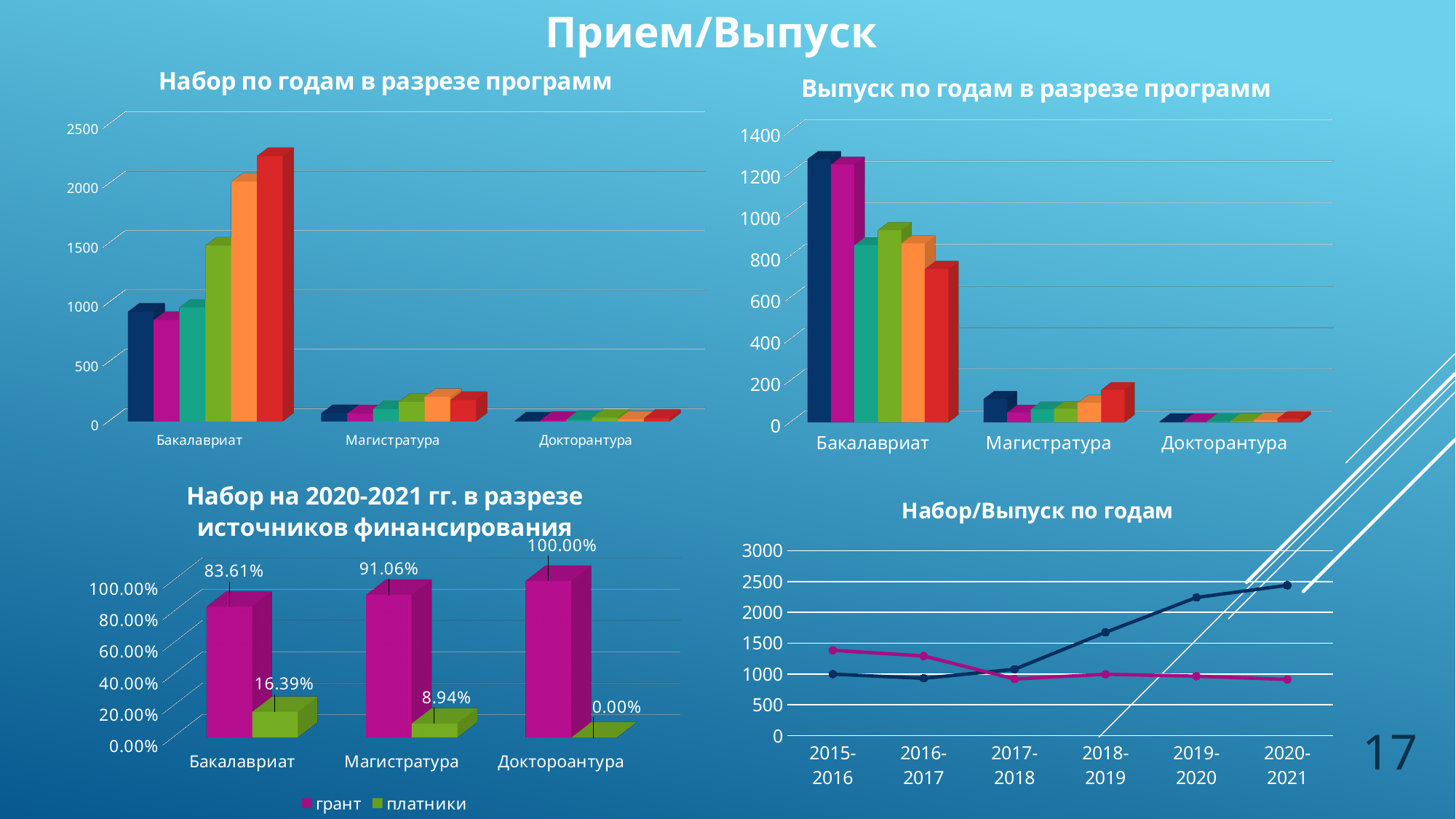
In the chart 'Набор по годам в разрезе программ', is the tallest bar for Бакалавриат greater or less than 2000? greater In the chart 'Набор на 2020-2021 гг. в разрезе источников финансирования', what is the difference between грант and платники for Бакалавриат? 67.22% What kind of chart is 'Выпуск по годам в разрезе программ'? bar chart In the chart 'Набор на 2020-2021 гг. в разрезе источников финансирования', what is the value for платники for Магистратура? 8.94% In the chart 'Набор/Выпуск по годам', does the dark blue line rise or fall from 2017-2018 to 2020-2021? rises How many year periods are shown on the x axis of the chart 'Набор/Выпуск по годам'? 6 How many series does the legend list in the chart 'Набор на 2020-2021 гг. в разрезе источников финансирования'? 2 In the chart 'Набор на 2020-2021 гг. в разрезе источников финансирования', what is the value for грант for Бакалавриат? 83.61% In the chart 'Набор на 2020-2021 гг. в разрезе источников финансирования', what is the value for платники for Докторантура? 0.00% In the chart 'Выпуск по годам в разрезе программ', are the bars for Докторантура greater or less than 200? less In the chart 'Набор на 2020-2021 гг. в разрезе источников финансирования', which category has the highest грант value? Докторантура How many categories are shown on the x axis of the chart 'Набор по годам в разрезе программ'? 3